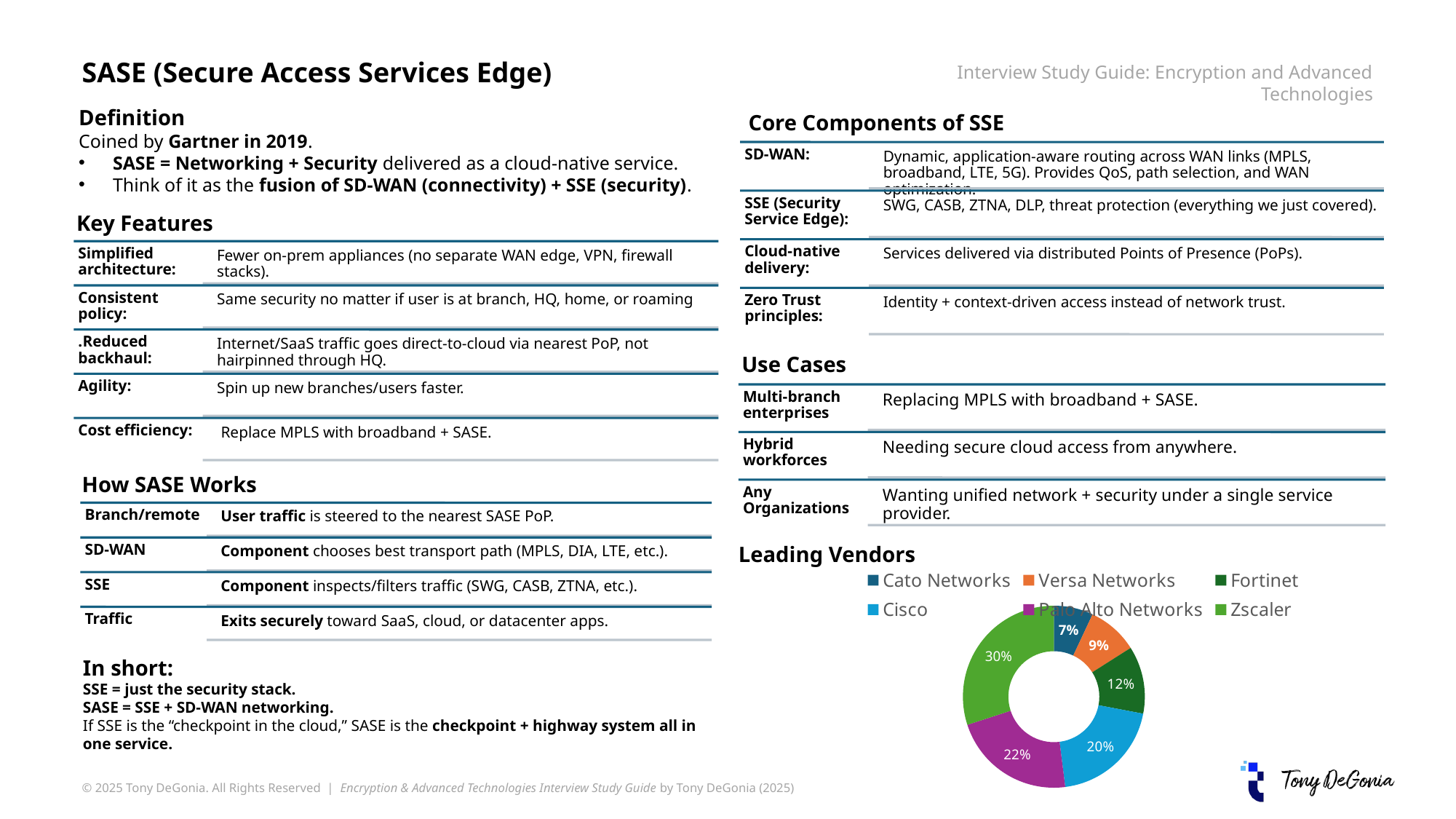
In the Leading Vendors chart, what share does Versa Networks have? 9% In the Leading Vendors chart, which has a larger share, Palo Alto Networks or Fortinet? Palo Alto Networks In the Leading Vendors chart, what share does Cisco have? 20% In the Leading Vendors chart, what is the difference between Zscaler's share and Cisco's share? 10% In the Leading Vendors chart, what share does Zscaler have? 30% In the Leading Vendors chart, what colour is the Versa Networks slice? Orange In the Leading Vendors chart, what share does Fortinet have? 12% How many vendors does the legend of the Leading Vendors chart list? 6 In the Leading Vendors chart, which vendor has the smallest share? Cato Networks In the Leading Vendors chart, which vendor has the largest share? Zscaler What kind of chart is shown under Leading Vendors? Donut (pie) chart In the Leading Vendors chart, what share does Cato Networks have? 7%